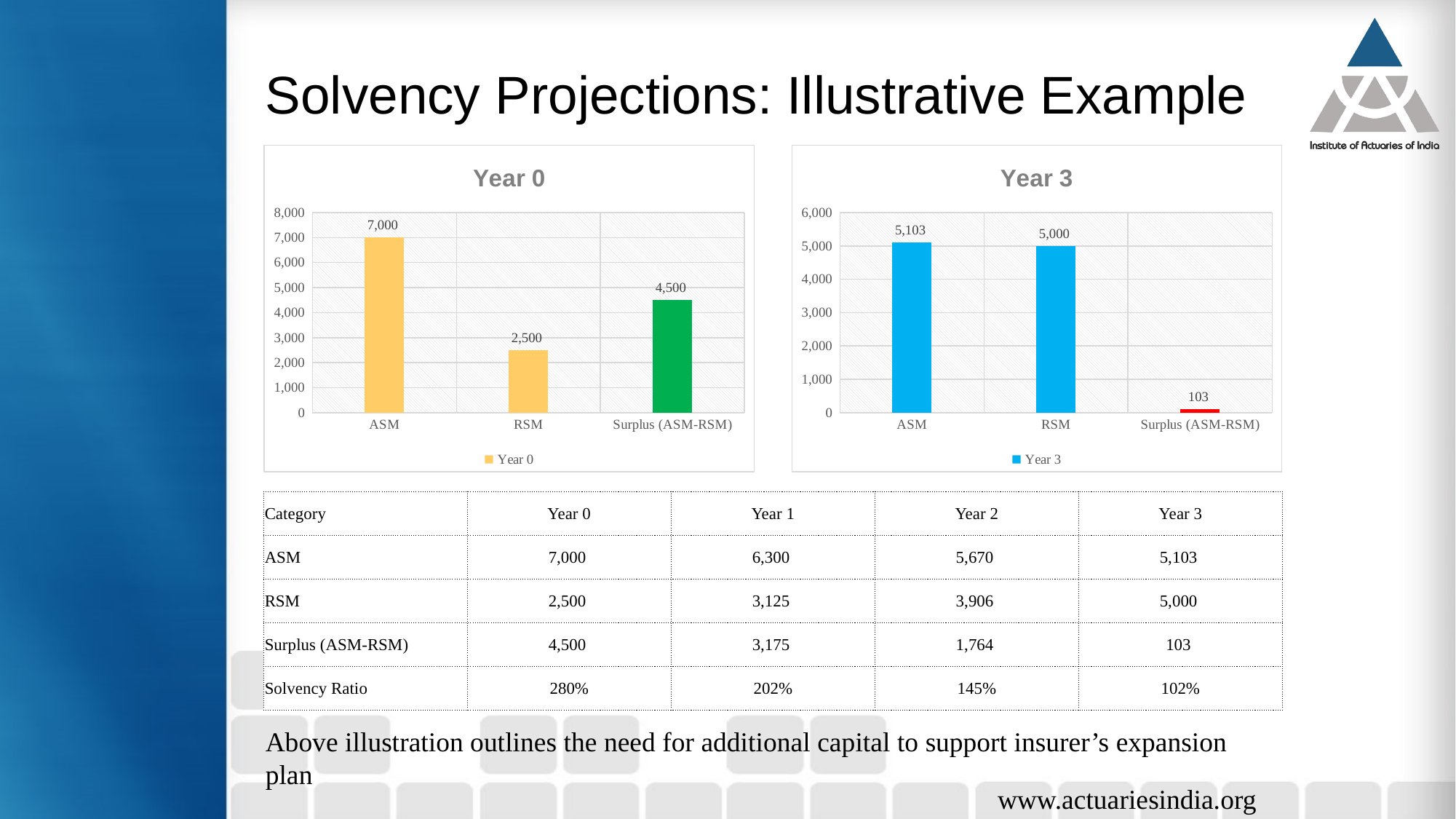
What type of chart is the Year 0 chart? Bar chart In the Year 3 chart, what is the value for Surplus (ASM-RSM)? 103 In the Year 3 chart, what is the value for ASM? 5,103 In the Year 0 chart, what is the value for RSM? 2,500 In the Year 0 chart, is the value for Surplus (ASM-RSM) greater or less than 4,000? greater In the Year 3 chart, which is larger, ASM or RSM? ASM In the Year 3 chart, which category has the lowest value? Surplus (ASM-RSM) In the Year 0 chart, which category has the highest value? ASM In the Year 0 chart, what is the difference between the ASM and RSM values? 4,500 What is the legend entry shown below the Year 3 chart? Year 3 In the Year 0 chart, what is the value for ASM? 7,000 How many categories are shown in the Year 3 chart? 3